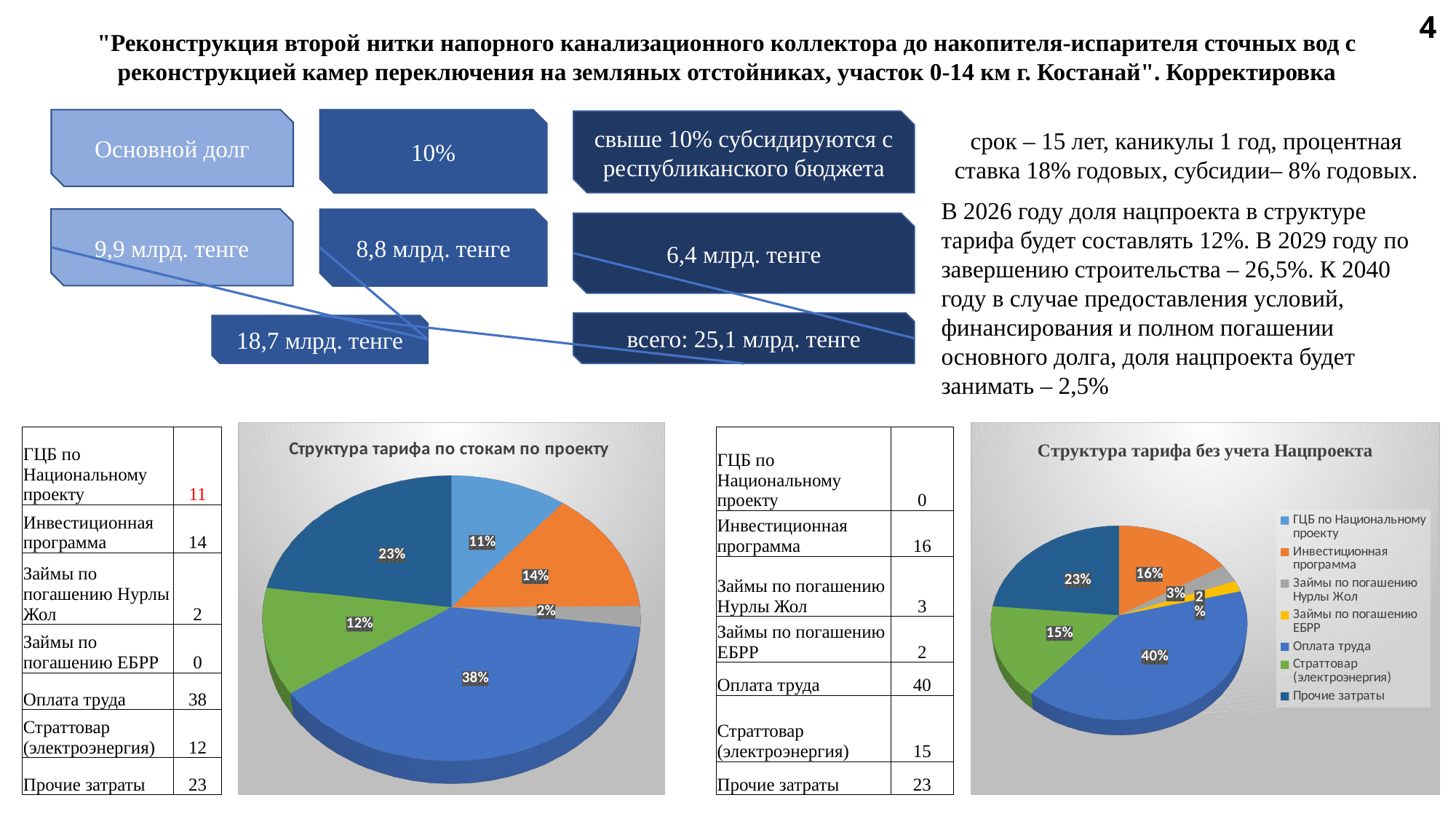
In the chart "Структура тарифа по стокам по проекту", what is the share labelled for ГЦБ по Национальному проекту? 11% In the chart "Структура тарифа по стокам по проекту", what is the smallest labelled slice? 2% How many entries does the legend of the chart "Структура тарифа без учета Нацпроекта" list? 7 In the chart "Структура тарифа по стокам по проекту", what is the share labelled for Прочие затраты? 23% What kind of chart is "Структура тарифа по стокам по проекту"? pie chart In the chart "Структура тарифа без учета Нацпроекта", what is the share for Инвестиционная программа? 16% What is the title of the pie chart on the right side of the slide? Структура тарифа без учета Нацпроекта In the chart "Структура тарифа без учета Нацпроекта", which is larger: Страттовар (электроэнергия) or Прочие затраты? Прочие затраты In the chart "Структура тарифа по стокам по проекту", what share does the largest slice (Оплата труда) have? 38% In the chart "Структура тарифа без учета Нацпроекта", what is the share for Оплата труда? 40% In the chart "Структура тарифа без учета Нацпроекта", what is the difference between Оплата труда and Страттовар (электроэнергия)? 25% In the chart "Структура тарифа по стокам по проекту", what is the difference between the Оплата труда slice and the Прочие затраты slice? 15%